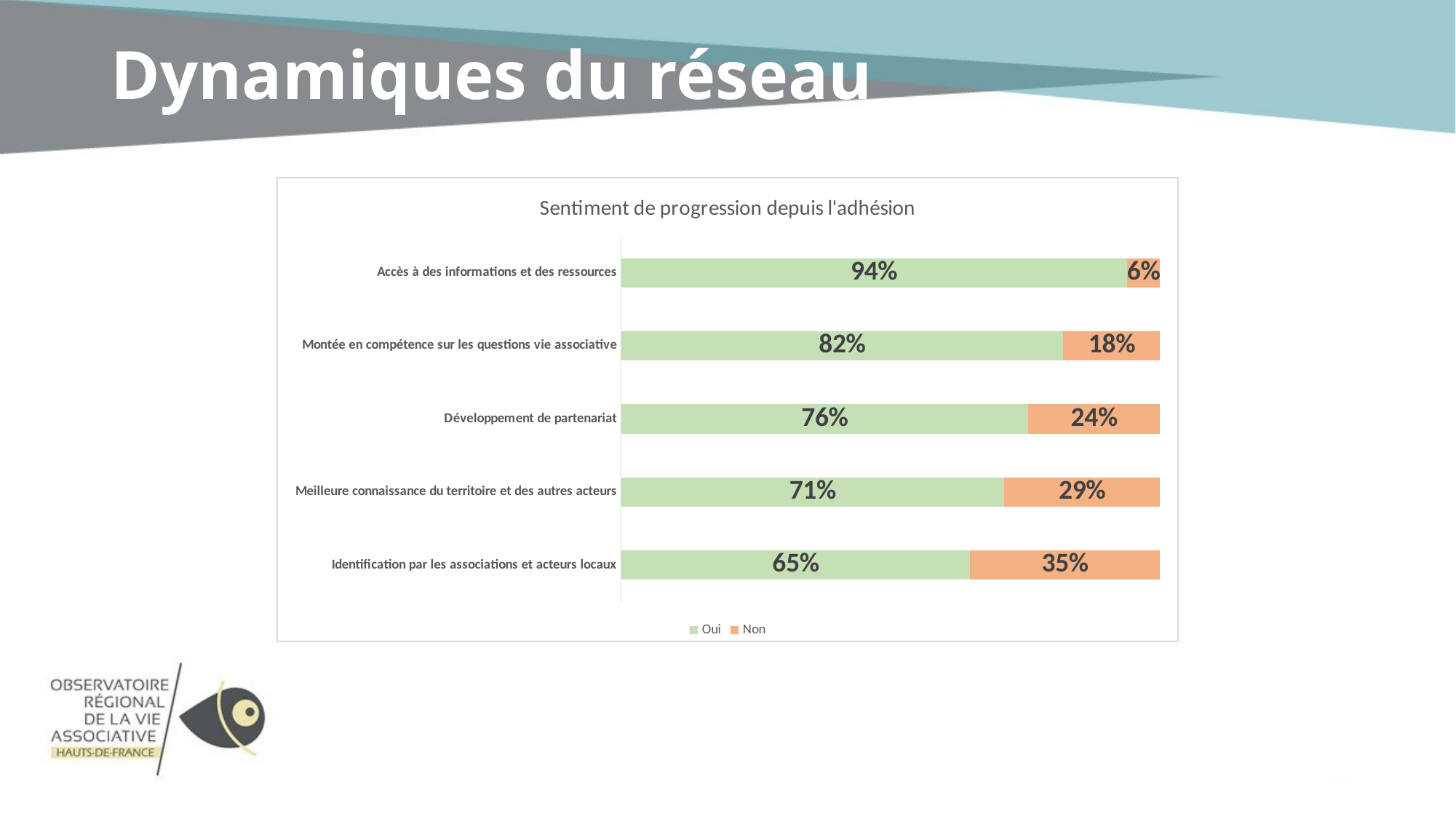
What is the 'Oui' value for 'Identification par les associations et acteurs locaux'? 65% Which category has the lowest 'Oui' value? Identification par les associations et acteurs locaux What is the 'Oui' value for 'Accès à des informations et des ressources'? 94% What is the 'Non' value for 'Développement de partenariat'? 24% What is the difference between the 'Oui' values for 'Montée en compétence sur les questions vie associative' and 'Développement de partenariat'? 6% What kind of chart is shown on the slide? Stacked bar chart How many categories are shown in the chart? 5 How many series does the legend list? 2 What is the total of the stacked bar for 'Meilleure connaissance du territoire et des autres acteurs'? 100% Which is larger: the 'Non' value for 'Meilleure connaissance du territoire et des autres acteurs' or the 'Non' value for 'Montée en compétence sur les questions vie associative'? Meilleure connaissance du territoire et des autres acteurs Which category has the highest 'Oui' value? Accès à des informations et des ressources What is the title of the chart? Sentiment de progression depuis l'adhésion